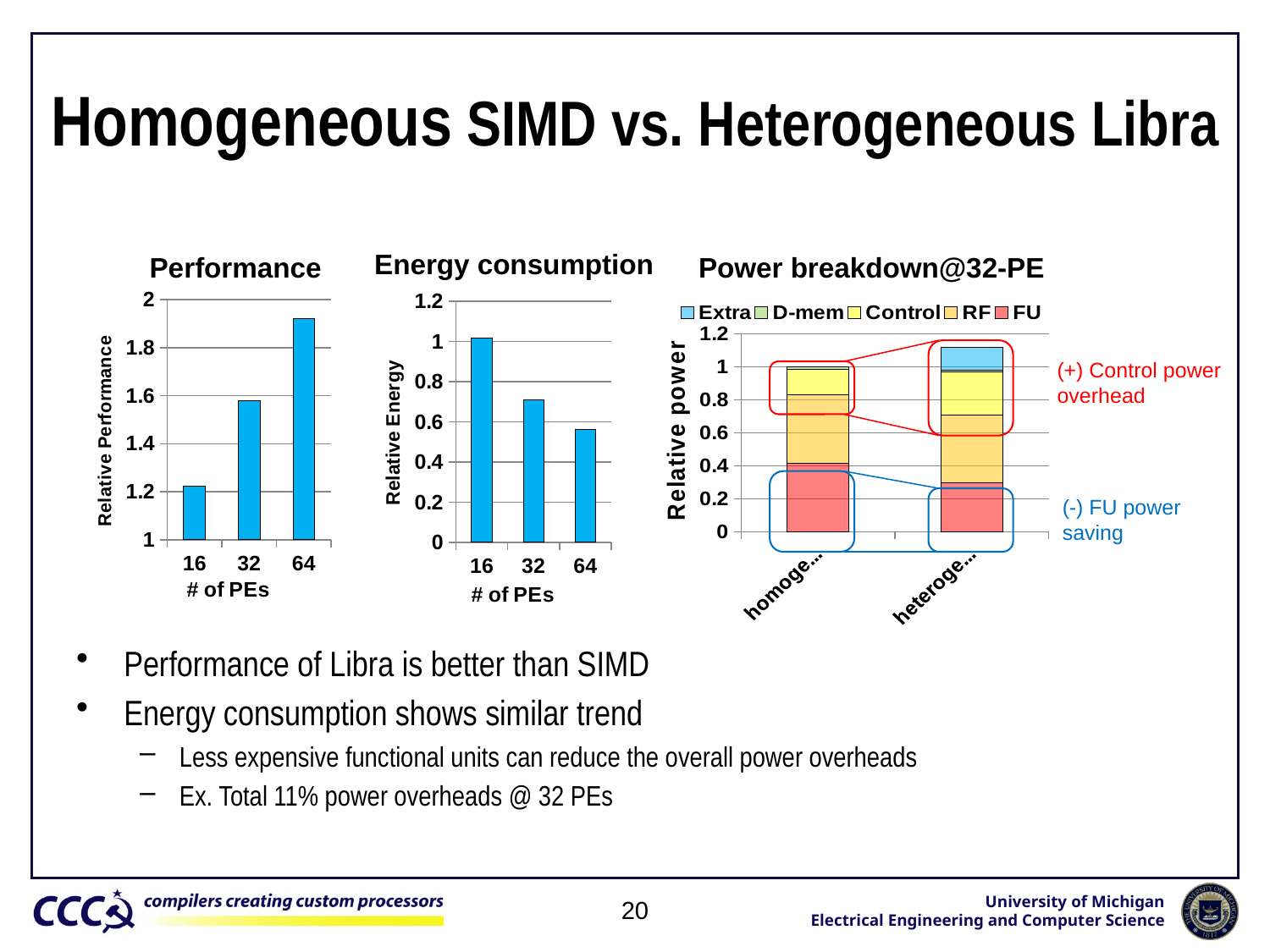
What type of chart is the Performance chart? bar chart In the Energy consumption chart, which number of PEs has the lowest relative energy? 64 How many series does the legend of the Power breakdown@32-PE chart list? 5 In the Performance chart, is the value for 16 PEs greater or less than 1.4? less In the Performance chart, which number of PEs has the lowest relative performance? 16 In the Energy consumption chart, is the value for 32 PEs greater or less than 0.6? greater In the Performance chart, is the value for 64 PEs greater or less than 1.8? greater In the Energy consumption chart, do the values rise or fall as the number of PEs increases? fall In the Performance chart, do the values rise or fall as the number of PEs increases? rise In the Performance chart, which number of PEs has the highest relative performance? 64 In the Power breakdown@32-PE chart, which bar has the larger total relative power, the left (homoge...) bar or the right (heteroge...) bar? the right (heteroge...) bar